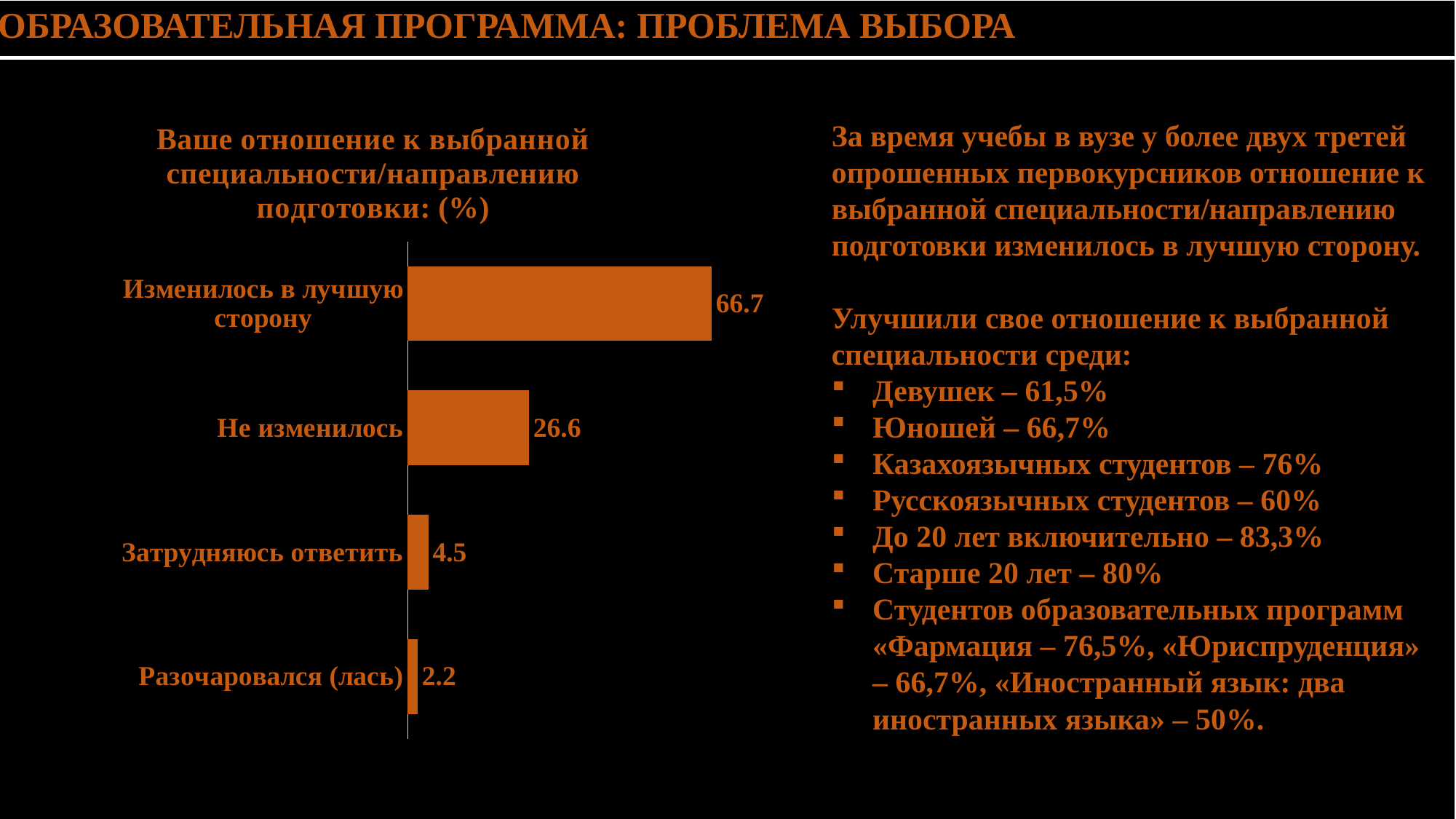
Which is larger, the value for "Не изменилось" or the value for "Затрудняюсь ответить"? Не изменилось What is the difference between the values for "Изменилось в лучшую сторону" and "Не изменилось"? 40.1 What kind of chart is shown on the slide? Bar chart What is the value for "Изменилось в лучшую сторону"? 66.7 Which category has the lowest value? Разочаровался (лась) What is the value for "Не изменилось"? 26.6 How many categories does the chart show? 4 Which category has the highest value? Изменилось в лучшую сторону What is the value for "Затрудняюсь ответить"? 4.5 What is the title of the chart? Ваше отношение к выбранной специальности/направлению подготовки: (%) What is the difference between the values for "Затрудняюсь ответить" and "Разочаровался (лась)"? 2.3 What is the value for "Разочаровался (лась)"? 2.2